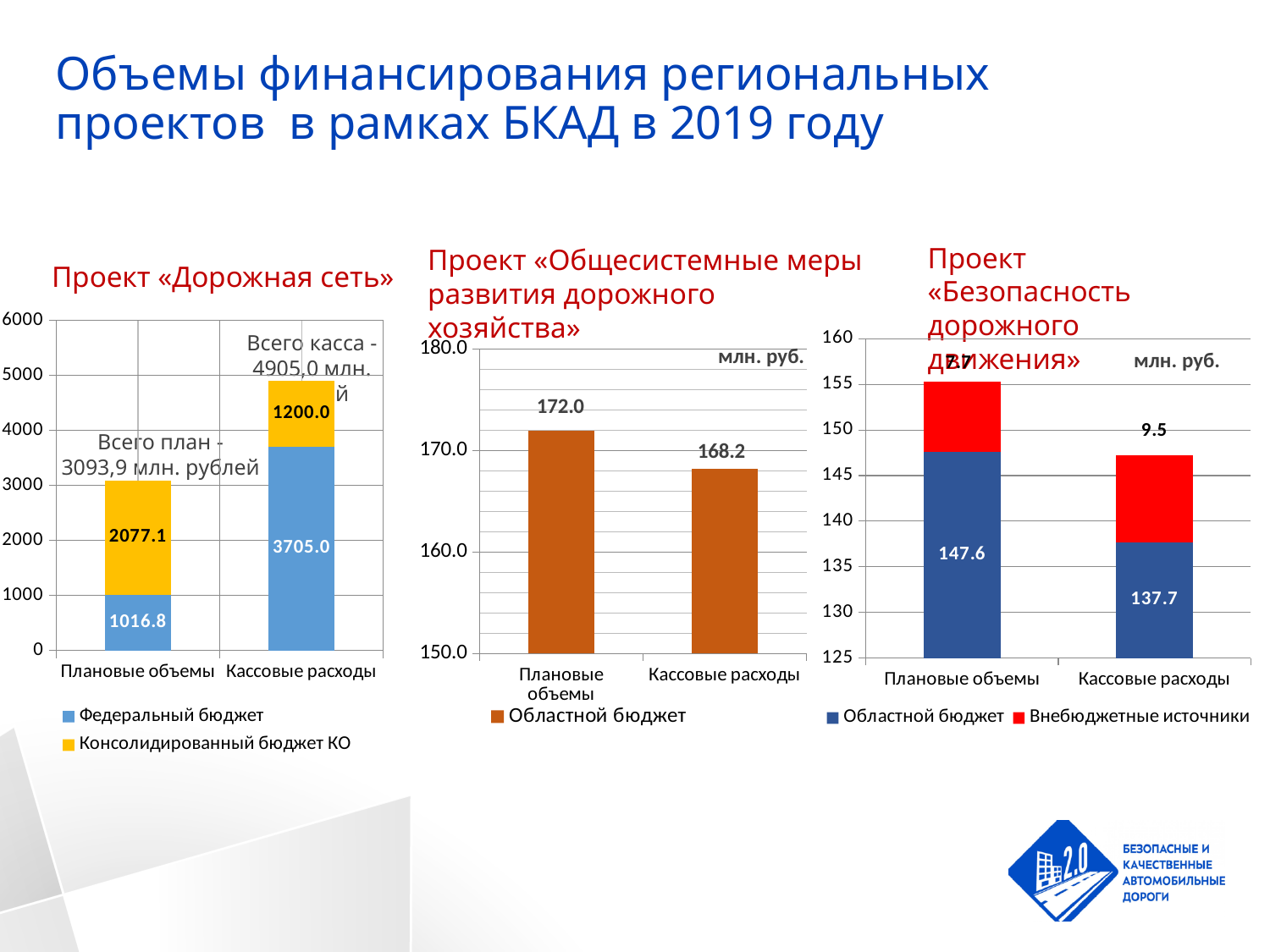
In the chart «Проект «Дорожная сеть»», how many series does the legend list? 2 In the chart «Проект «Безопасность дорожного движения»», what is the value of Областной бюджет for Кассовые расходы? 137.7 In the chart «Проект «Дорожная сеть»», which category has the larger Федеральный бюджет value, Плановые объемы or Кассовые расходы? Кассовые расходы In the chart «Проект «Общесистемные меры развития дорожного хозяйства»», what is the value for Плановые объемы? 172.0 In the chart «Проект «Безопасность дорожного движения»», which series is shown in red according to the legend? Внебюджетные источники In the chart «Проект «Безопасность дорожного движения»», what is the value of Внебюджетные источники for Кассовые расходы? 9.5 In the chart «Проект «Общесистемные меры развития дорожного хозяйства»», what is the difference between Плановые объемы and Кассовые расходы? 3.8 What kind of chart is «Проект «Общесистемные меры развития дорожного хозяйства»»? bar chart In the chart «Проект «Общесистемные меры развития дорожного хозяйства»», how many categories are shown on the x axis? 2 In the chart «Проект «Дорожная сеть»», what is the total of the stacked bar for Плановые объемы? 3093.9 In the chart «Проект «Дорожная сеть»», what is the value of Консолидированный бюджет КО for Плановые объемы? 2077.1 In the chart «Проект «Дорожная сеть»», what is the value of Федеральный бюджет for Кассовые расходы? 3705.0